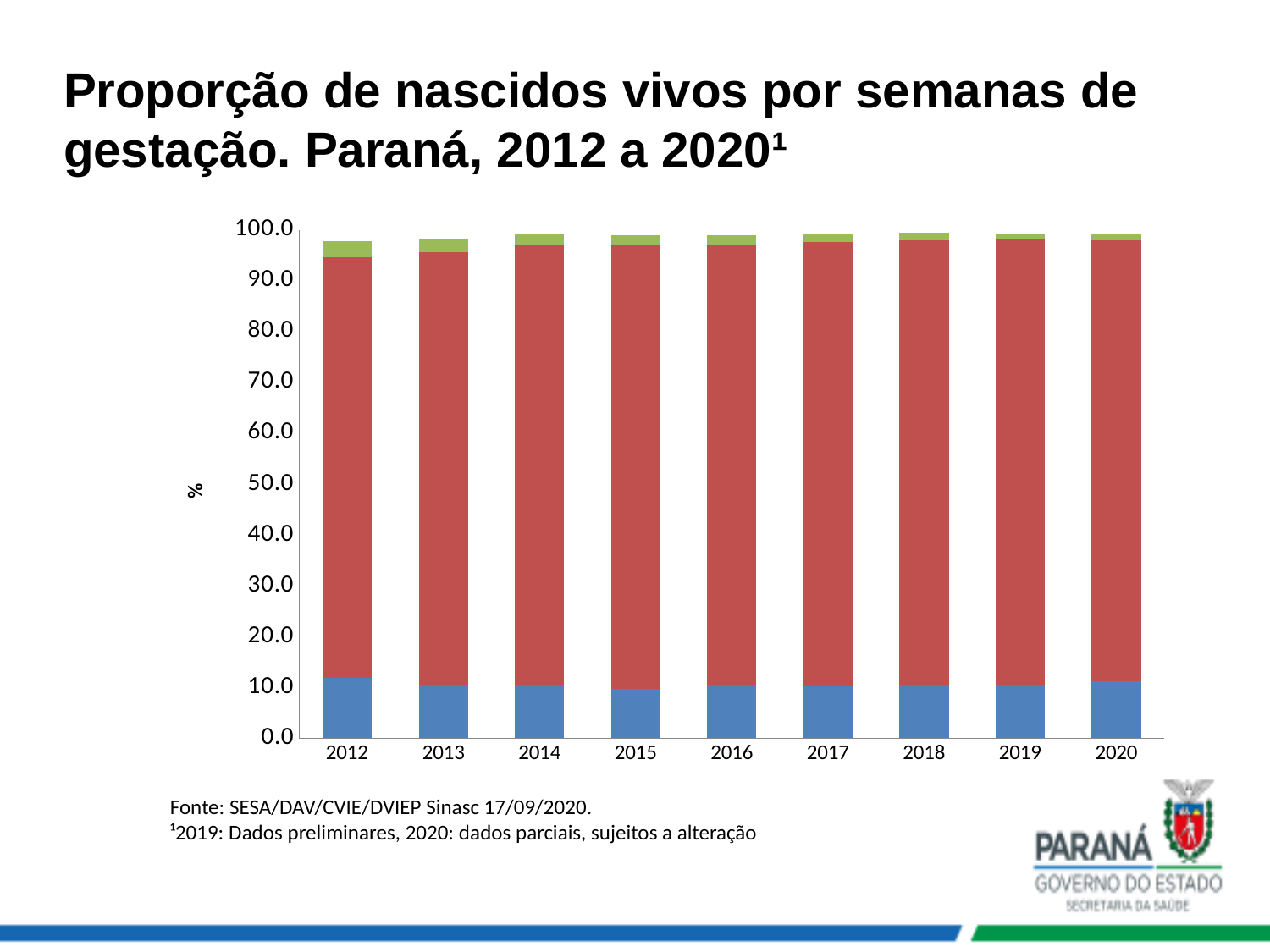
How many coloured segments make up each stacked bar in the chart? 3 What kind of chart is shown on the slide? bar chart Is the blue segment of the bar for 2020 greater or less than 30? less Is the blue segment of the bar for 2012 greater or less than 20? less Is the blue segment of the bar for 2015 greater or less than 20? less What is the label on the vertical axis of the chart? % Which year has the larger blue segment, 2012 or 2015? 2012 How many years are shown along the x axis of the chart? 9